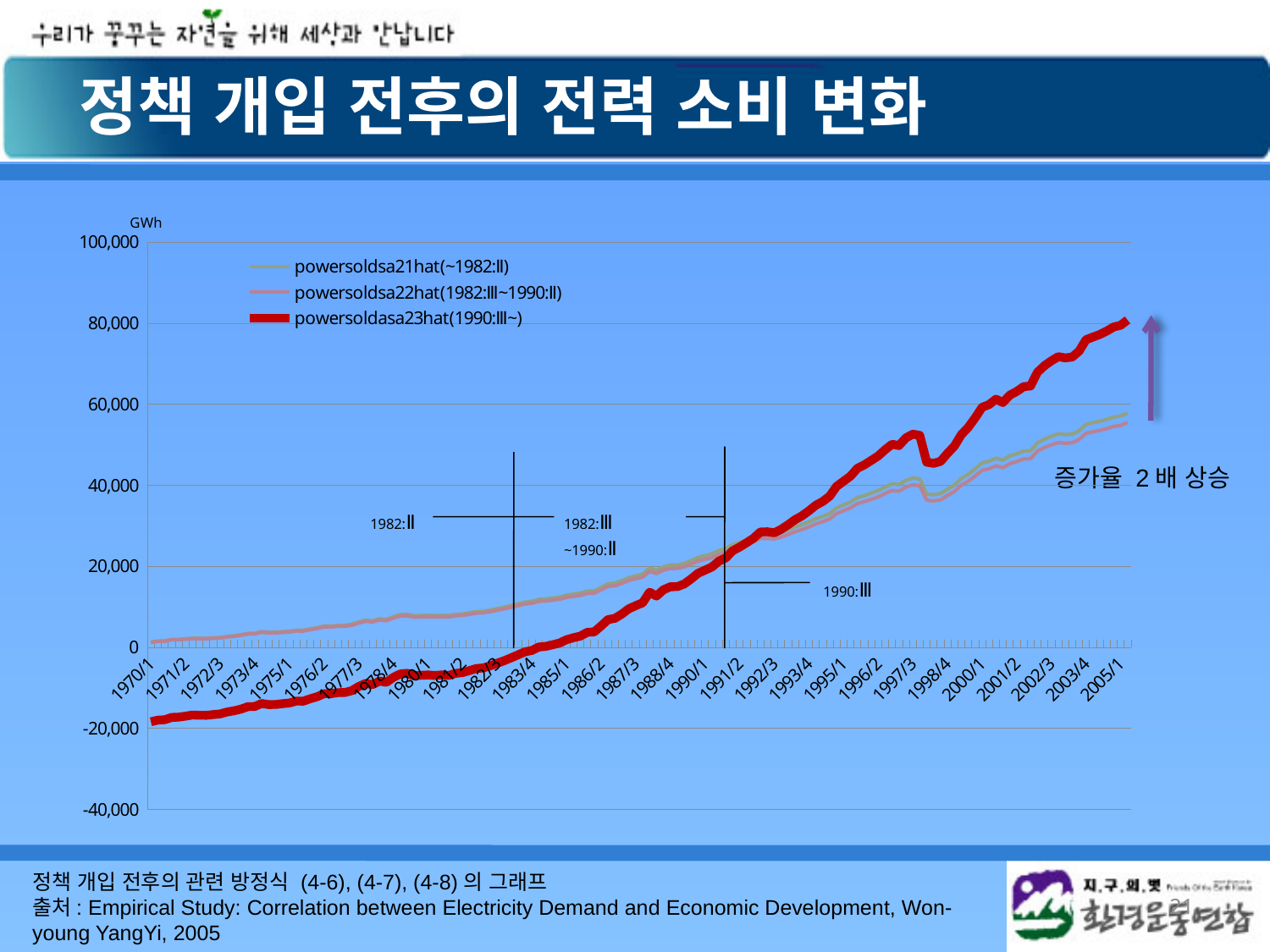
What is the highest value labelled on the y axis? 100,000 Which legend entry is drawn as the thick red line? powersoldasa23hat(1990:Ⅲ~) Is the value of the powersoldsa22hat line at 2005/1 greater or less than 60,000? less At 1980/1, which line is higher: powersoldsa22hat (pink) or powersoldasa23hat (thick red)? powersoldsa22hat Is the value of the thick red line (powersoldasa23hat) at 1970/1 greater or less than 0? less How many series does the chart legend list? 3 Does the thick red line (powersoldasa23hat) rise or fall overall from 1970/1 to 2005/1? rise What unit is shown at the top of the y axis? GWh At 2005/1, which line is higher: powersoldasa23hat (thick red) or powersoldsa22hat (pink)? powersoldasa23hat Is the value of the thick red line (powersoldasa23hat) at 2005/1 greater or less than 60,000? greater What kind of chart is shown on the slide? line chart